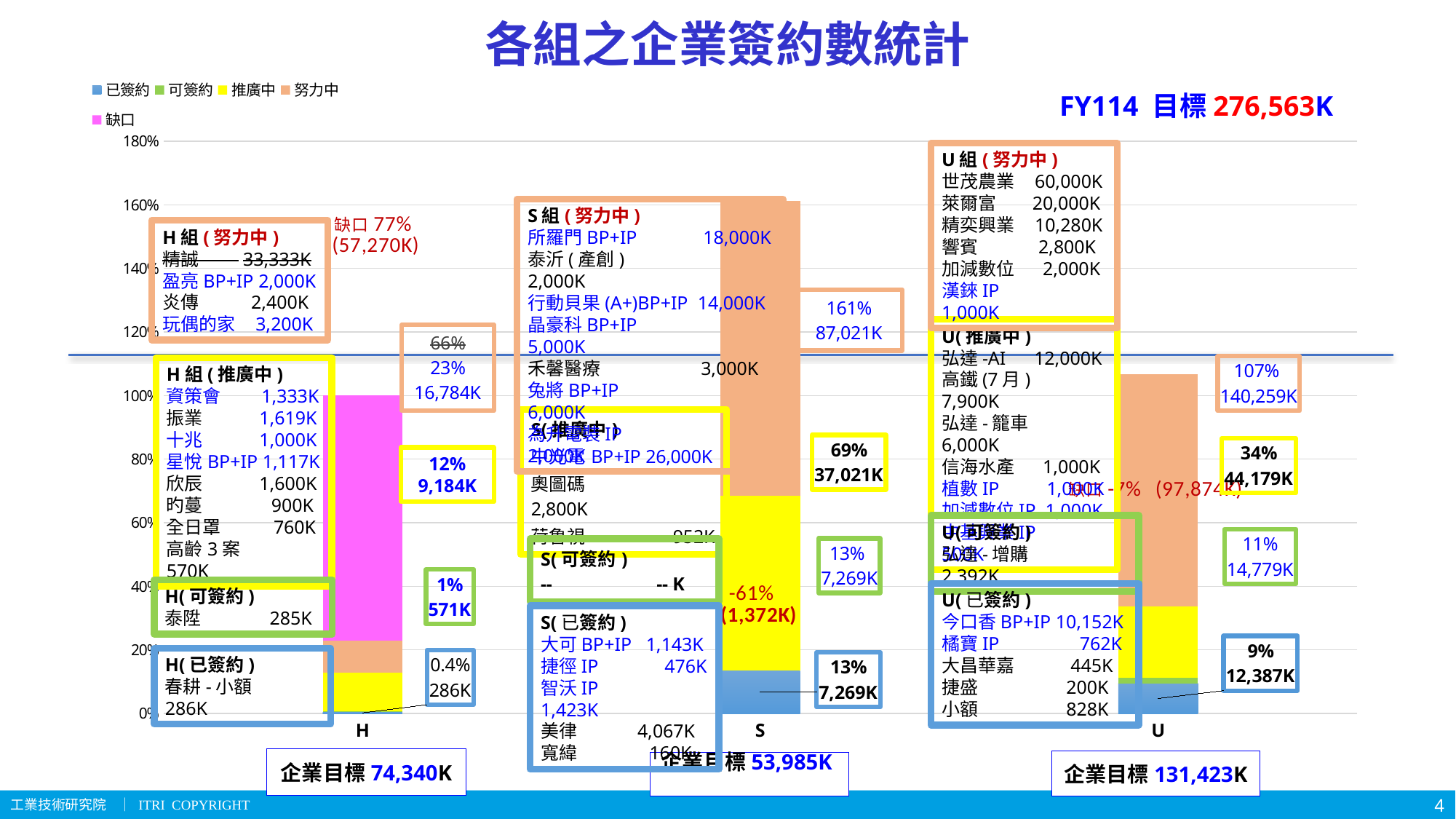
What is the 企業目標 (enterprise target) shown for group U? 131,423K What is the difference between the 企業目標 of group U and group H? 57,083K How many series does the chart legend list? 5 What kind of chart is shown on the slide? stacked bar chart Which group has the highest 企業目標 (enterprise target)? U How many groups (categories) are plotted along the x axis of the chart? 3 What is the 企業目標 (enterprise target) shown for group H? 74,340K What value is labelled for the 努力中 segment of group U? 140,259K What percentage is labelled for the 缺口 (gap) of group H? 77% What is the title of the chart on the slide? 各組之企業簽約數統計 Which series in the legend is shown in magenta (pink)? 缺口 What is the FY114 目標 (target) shown on the slide? 276,563K